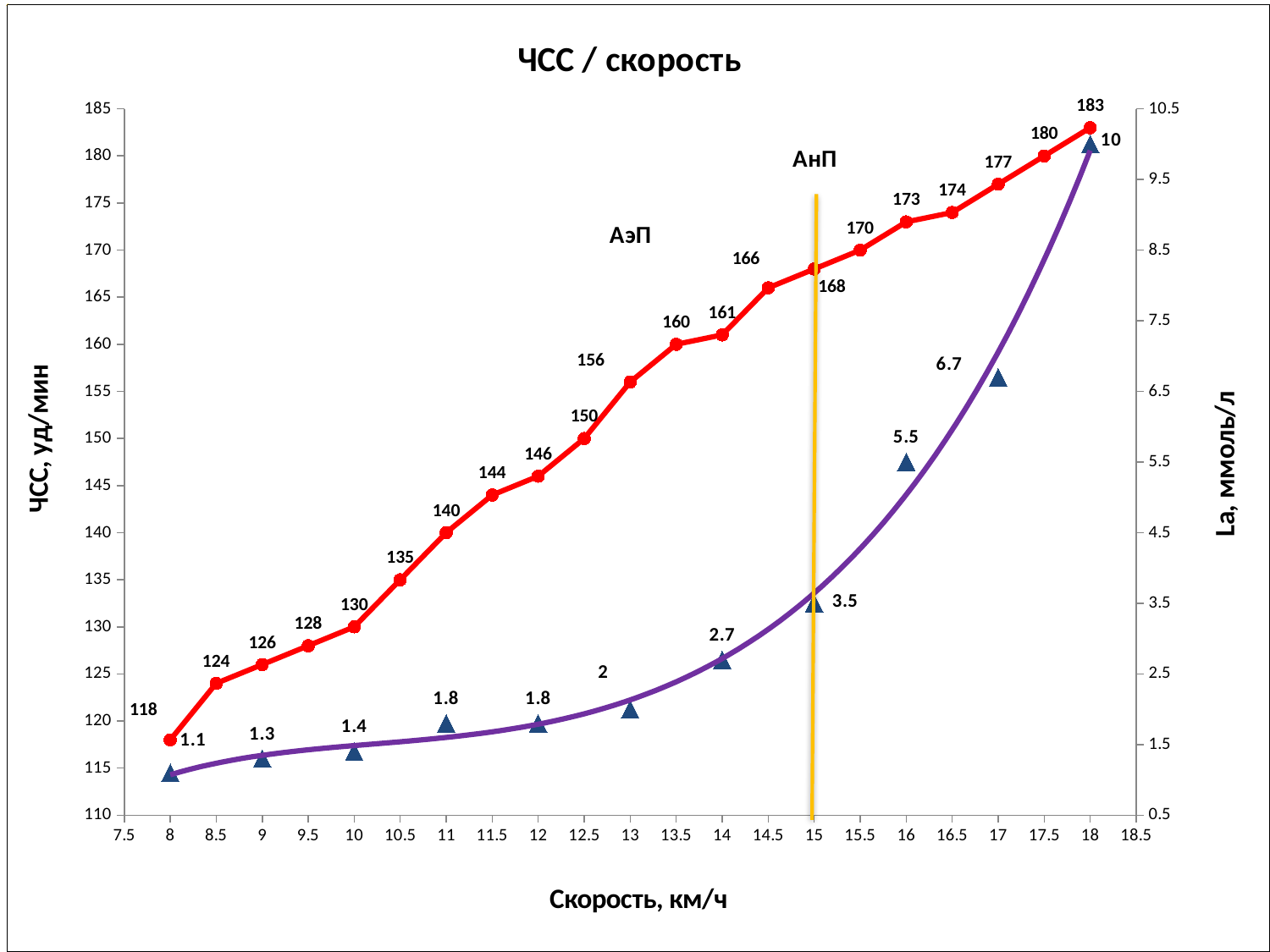
What is the heart rate value at a speed of 15 km/h, where the АнП line is drawn? 168 What is the highest heart rate value shown on the chart? 183 What type of chart is shown on the slide? Line chart Which is larger: the heart rate at 13 km/h or the heart rate at 11 km/h? 13 km/h Does the heart rate rise or fall as speed increases along the x axis? Rises What is the difference between the heart rate at 18 km/h and the heart rate at 8 km/h? 65 What is the heart rate (ЧСС) value at a speed of 12 km/h? 146 At what speed is the vertical line labelled АнП drawn? 15 What is the difference between the lactate value at 17 km/h and at 16 km/h? 1.2 What is the lowest lactate value shown on the chart? 1.1 What is the lactate (La) value at a speed of 16 km/h? 5.5 How many lactate (triangle) data points are plotted on the chart? 11